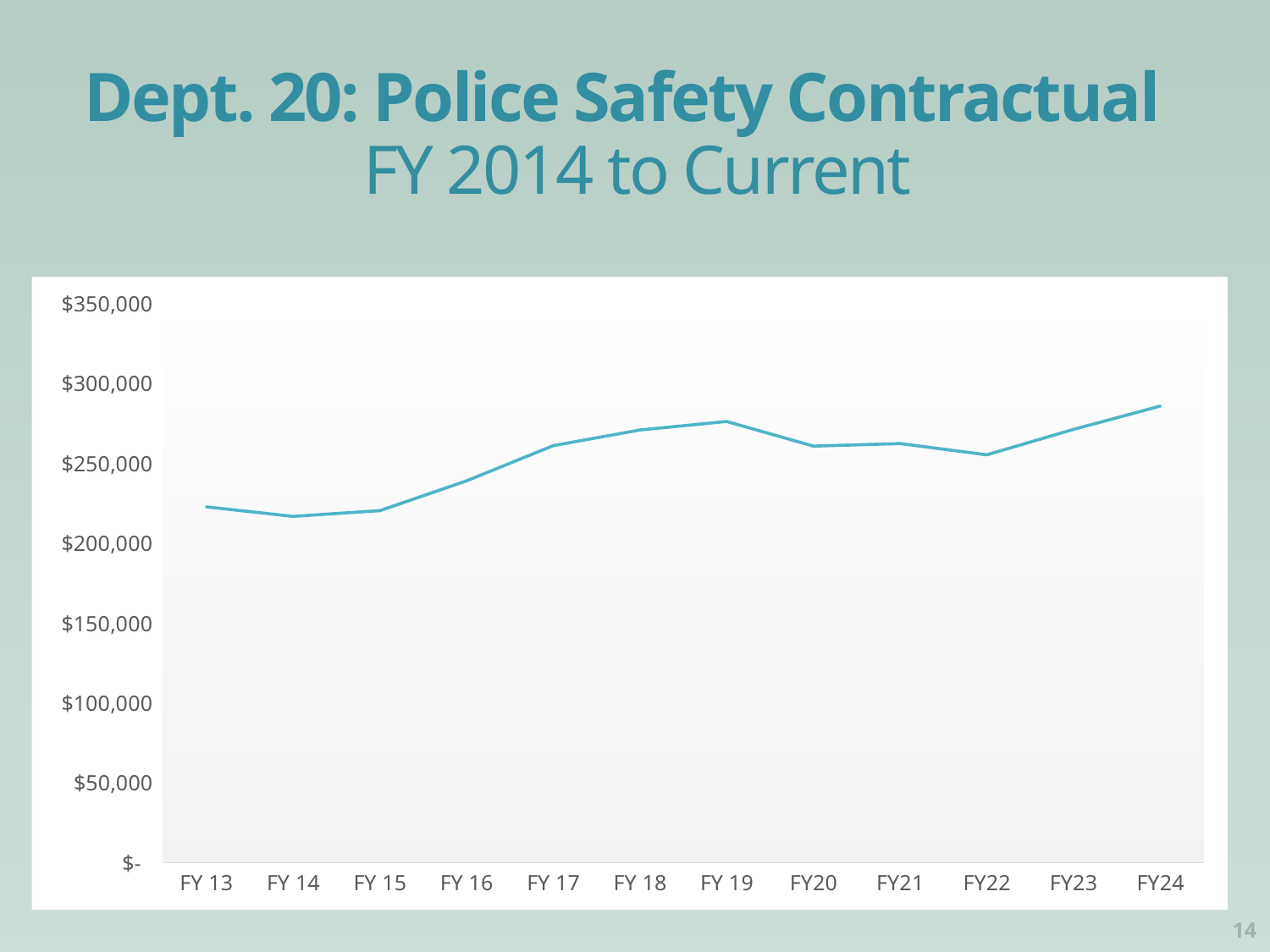
Is the value for FY 13 greater or less than $250,000? less How many fiscal years are plotted along the x axis? 12 What is the title of the slide containing the chart? Dept. 20: Police Safety Contractual FY 2014 to Current What kind of chart is shown on the slide? line chart Is the value for FY 14 greater or less than $250,000? less Is the value for FY 19 greater or less than $250,000? greater Which fiscal year has the highest value on the chart? FY24 Which is larger, the value for FY 13 or the value for FY24? FY24 Overall, do the values rise or fall from FY 13 to FY24? rise Which is larger, the value for FY 19 or the value for FY22? FY 19